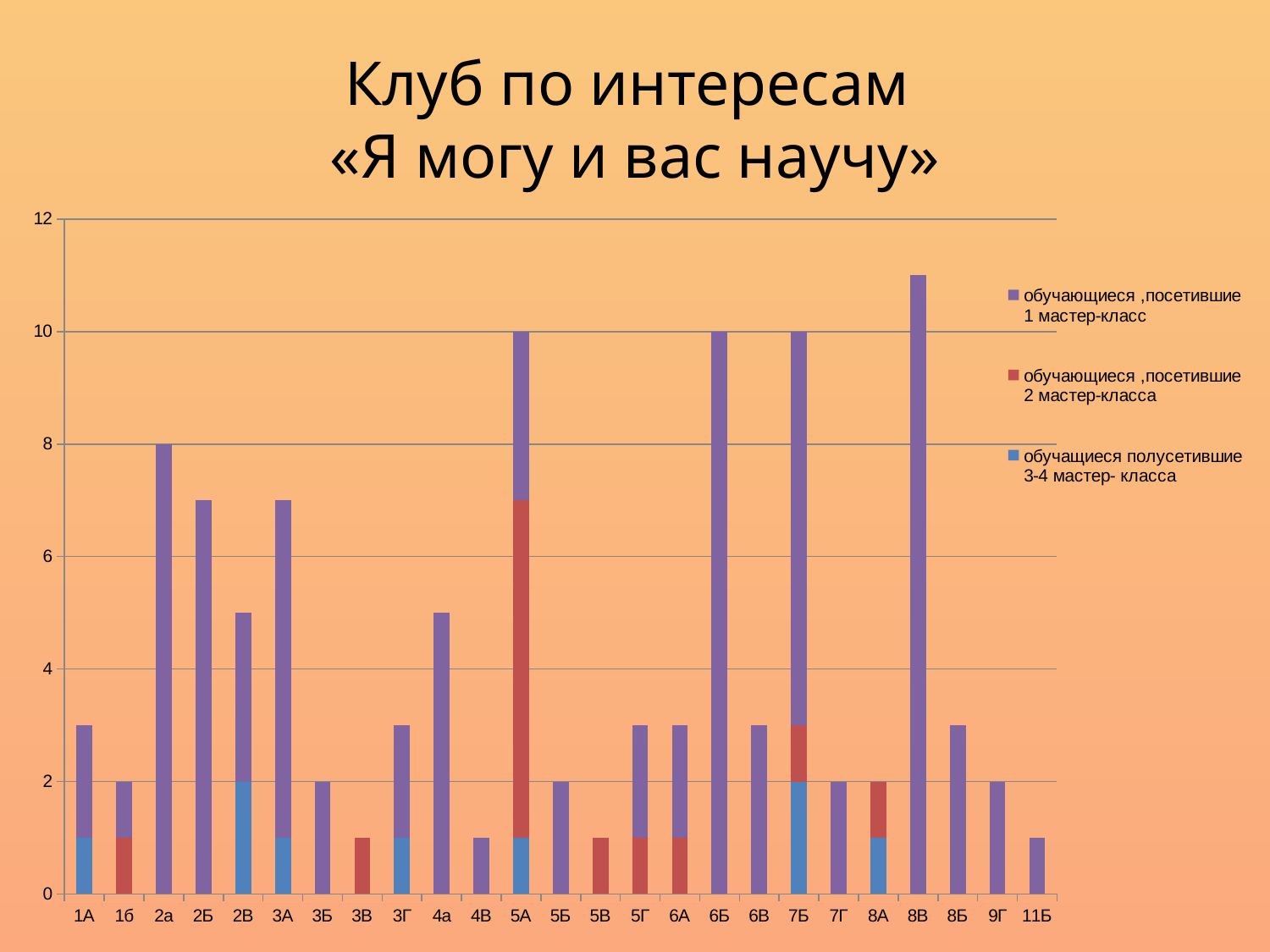
Which colour represents the series 'обучающиеся, посетившие 1 мастер-класс'? purple What is the total height of the bar for 2а? 8 How many series does the legend list? 3 Is the total value for 8В greater or less than 10? greater What kind of chart is shown on the slide? bar chart How many class categories are shown along the x axis? 25 Which bar is taller, 5А or 4а? 5А What is the difference between the total for 5А and the total for 2а? 2 What is the total height of the bar for 6Б? 10 What is the value of the blue segment (3-4 мастер-класса) for 2В? 2 Which class has the tallest stacked bar? 8В Is the total value for 3В greater or less than 2? less